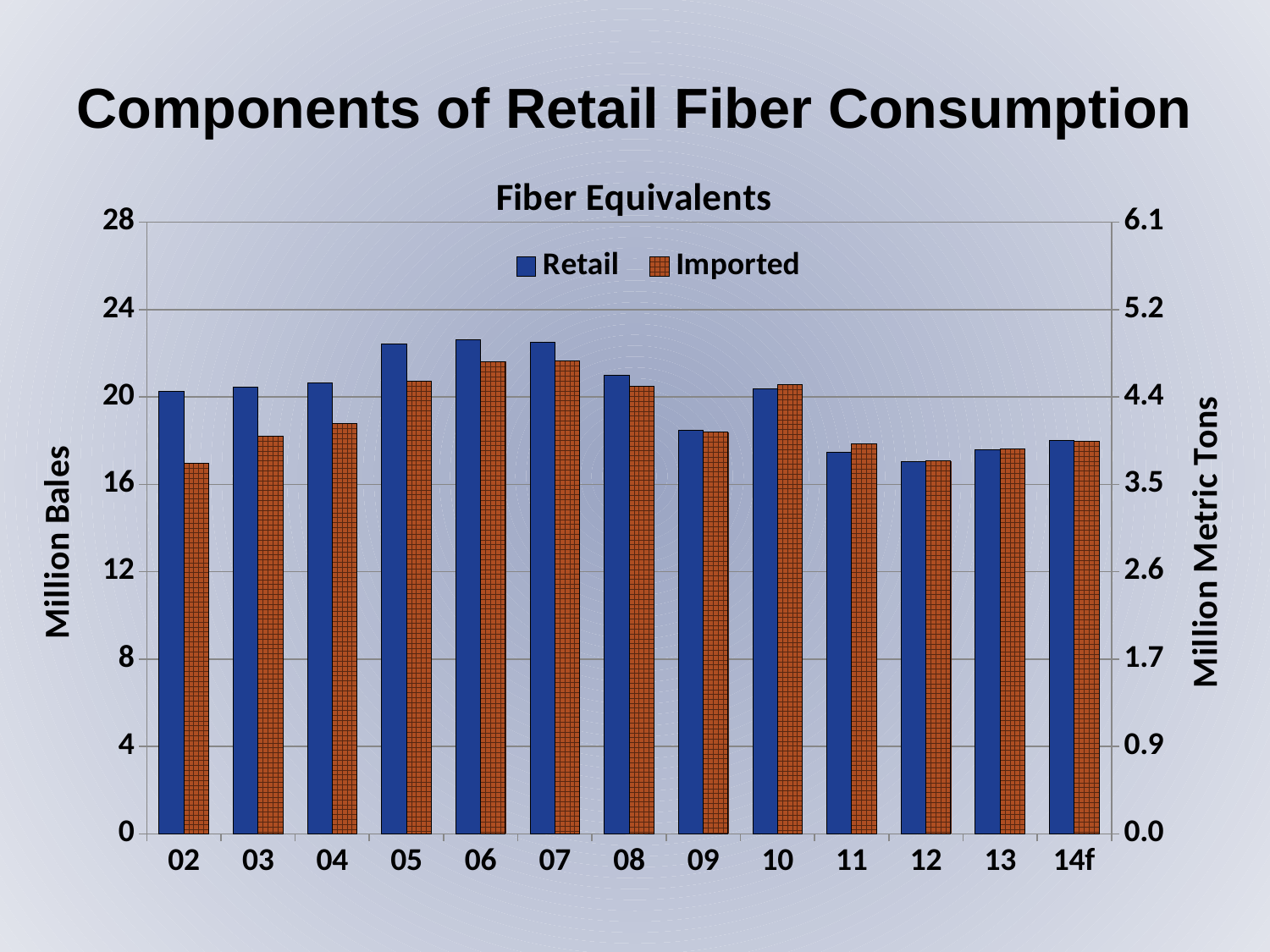
In 02, which is larger, Retail or Imported? Retail What kind of chart is shown on the slide? bar chart Is the Imported value for 06 greater or less than 20 million bales? greater How many years are shown on the x axis? 13 Is the Imported value for 02 greater or less than 20 million bales? less Do the Retail values rise or fall from 07 to 09? fall Is the Retail value for 05 greater or less than 20 million bales? greater What is the title of the left vertical axis? Million Bales How many series does the legend list? 2 In 04, which is larger, Retail or Imported? Retail